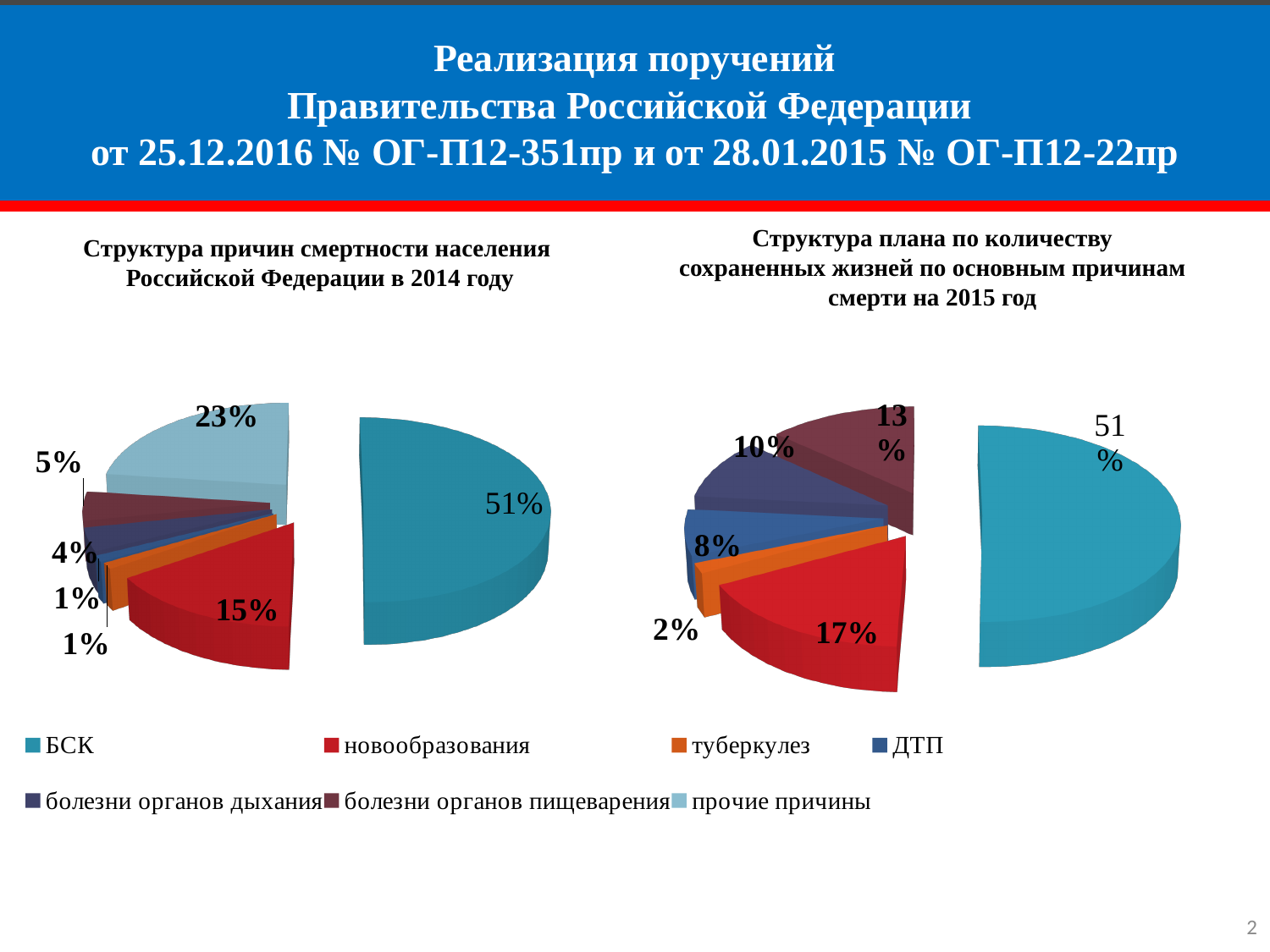
In the right chart (Структура плана по количеству сохраненных жизней по основным причинам смерти на 2015 год), what share is болезни органов пищеварения? 13% What type of chart is used on this slide? Pie chart In the right chart (Структура плана по количеству сохраненных жизней по основным причинам смерти на 2015 год), which category has the smallest share? туберкулез In the left chart (Структура причин смертности населения Российской Федерации в 2014 году), which is larger: болезни органов дыхания or болезни органов пищеварения? болезни органов пищеварения In the left chart (Структура причин смертности населения Российской Федерации в 2014 году), which category has the largest share? БСК In the left chart (Структура причин смертности населения Российской Федерации в 2014 году), what share is новообразования? 15% How many entries does the shared legend list? 7 In the right chart (Структура плана по количеству сохраненных жизней по основным причинам смерти на 2015 год), what is the difference between the shares of БСК and новообразования? 34% In the left chart (Структура причин смертности населения Российской Федерации в 2014 году), what share is БСК? 51% In the right chart (Структура плана по количеству сохраненных жизней по основным причинам смерти на 2015 год), what share is новообразования? 17% In the left chart (Структура причин смертности населения Российской Федерации в 2014 году), what share is прочие причины? 23% In the right chart (Структура плана по количеству сохраненных жизней по основным причинам смерти на 2015 год), what share is ДТП? 8%